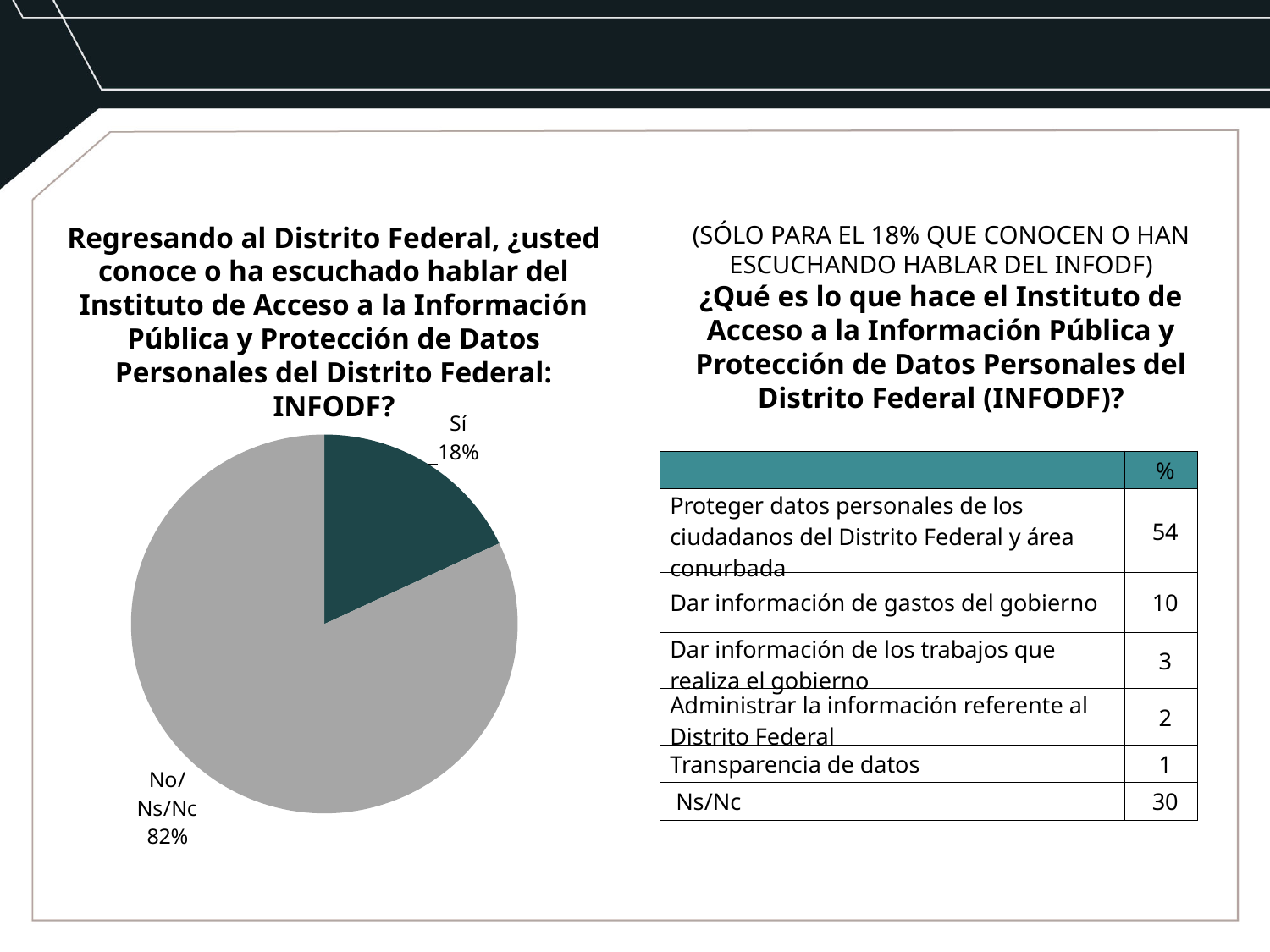
What colour is the "Sí" slice of the pie chart? dark teal Which slice of the pie chart is the smallest? Sí Which slice of the pie chart is the largest? No/Ns/Nc Which is larger in the pie chart, the "Sí" slice or the "No/Ns/Nc" slice? No/Ns/Nc How many slices does the pie chart have? 2 What share of the pie chart is labelled "Sí"? 18% What share of the pie chart is labelled "No/Ns/Nc"? 82% What is the difference in percentage points between the "No/Ns/Nc" slice and the "Sí" slice? 64 What colour is the "No/Ns/Nc" slice of the pie chart? grey What kind of chart is shown on the slide? pie chart